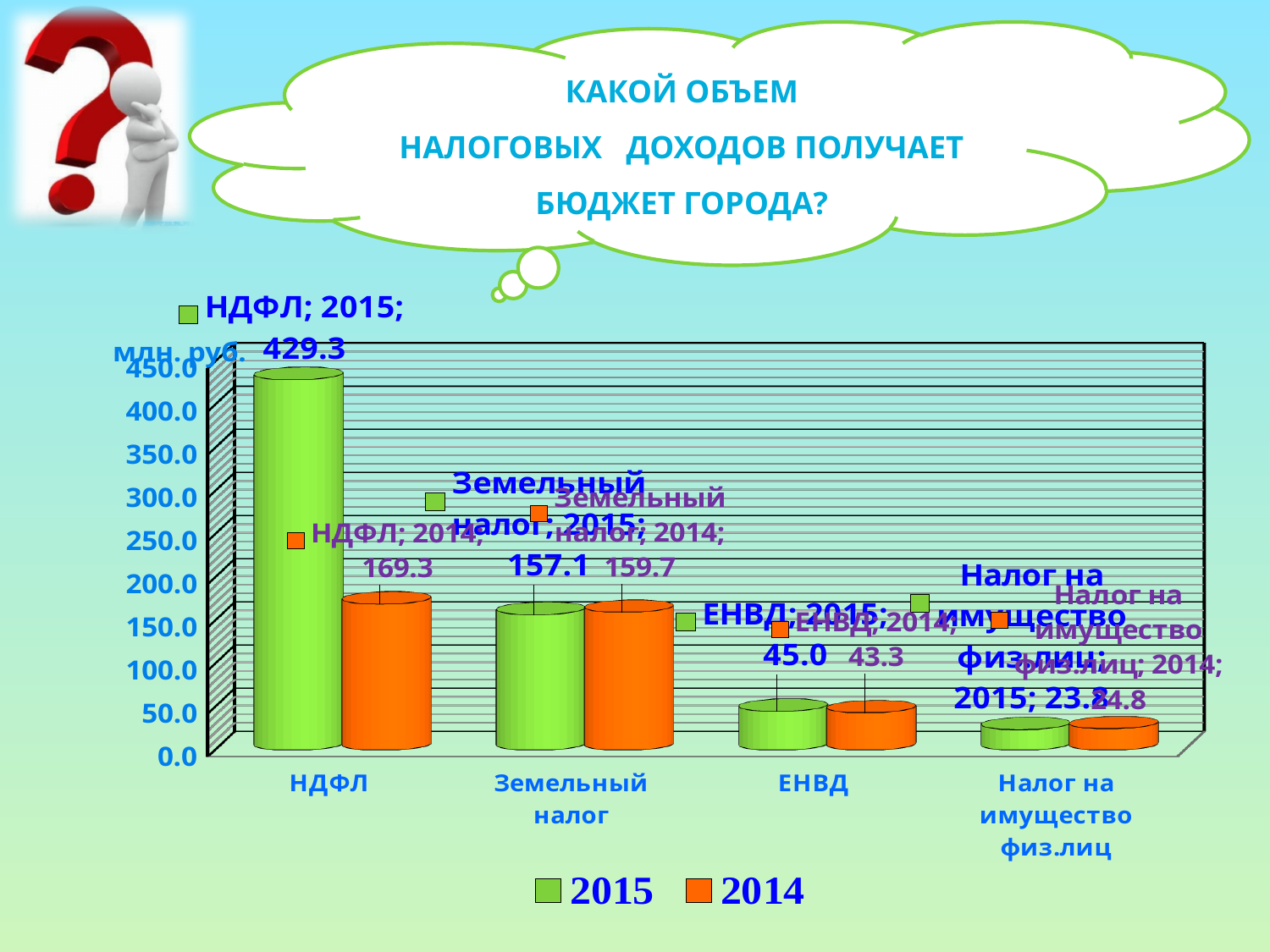
Which category has the highest value in 2015? НДФЛ Which is larger for Земельный налог: the 2015 value or the 2014 value? 2014 What unit is shown on the vertical axis of the chart? млн. руб. How many series does the legend list? 2 What is the value for НДФЛ in 2014? 169.3 What kind of chart is shown on the slide? Bar chart What is the difference between the 2015 and 2014 values for НДФЛ? 260.0 How many categories are shown on the x axis? 4 What is the value for НДФЛ in 2015? 429.3 What is the value for ЕНВД in 2014? 43.3 Which category has the lowest value in 2014? Налог на имущество физ.лиц What is the value for Земельный налог in 2015? 157.1